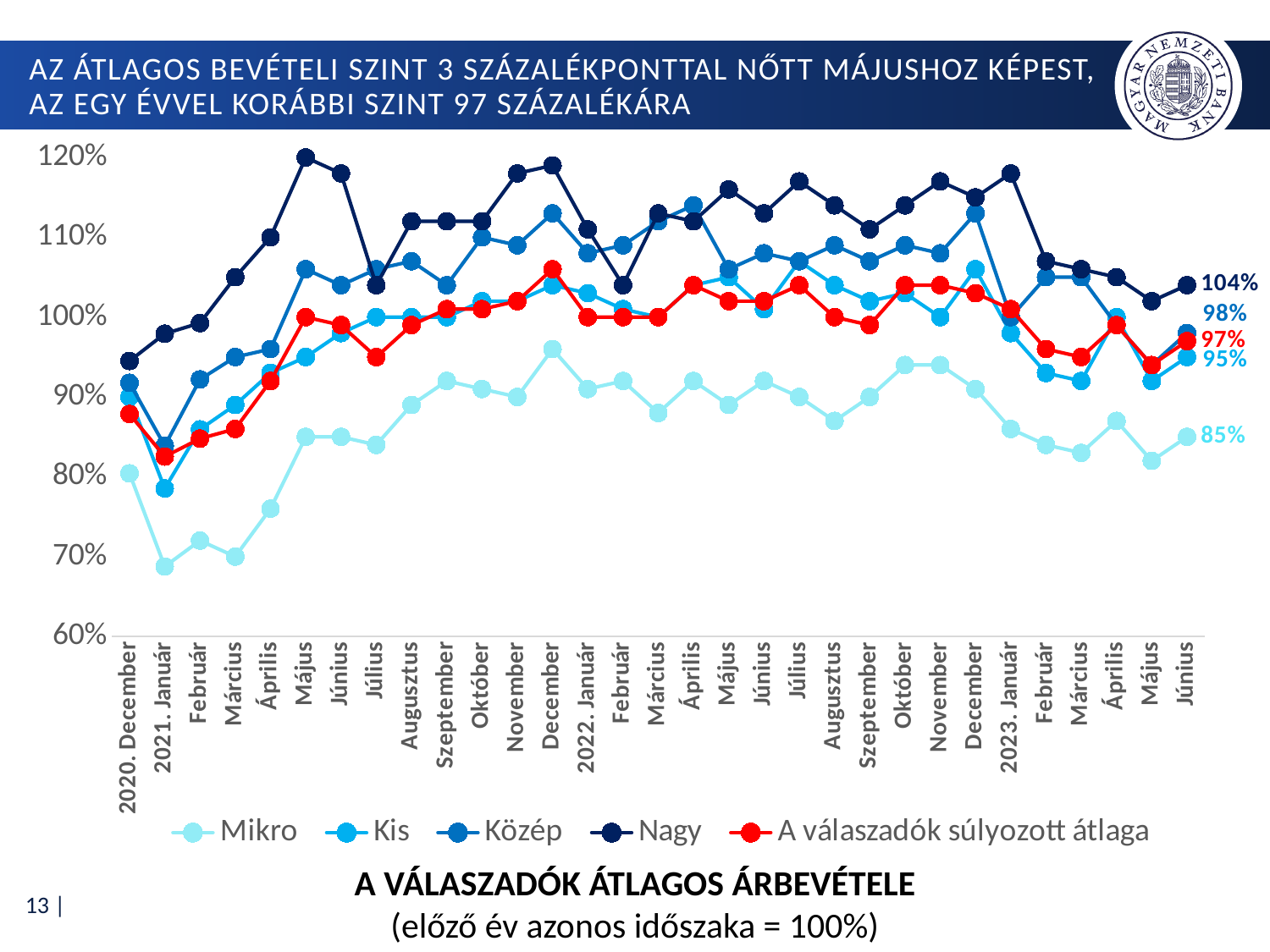
How many series does the legend list? 5 What is the difference between the Nagy and Mikro values at 2023 Június? 19 percentage points What is the value of the Mikro series at 2023 Június? 85% What is the value of the Közép series at 2023 Június? 98% What kind of chart is shown on the slide? line chart Is the value for Mikro at 2021. Január greater or less than 70%? less Which series has the lowest value at 2023 Június? Mikro What is the value of the Kis series at 2023 Június? 95% Which series has the highest value at 2023 Június? Nagy Is the value for Nagy at 2021 Május greater or less than 110%? greater What is the value of the Nagy series at 2023 Június? 104% What is the value of 'A válaszadók súlyozott átlaga' at 2023 Június? 97%